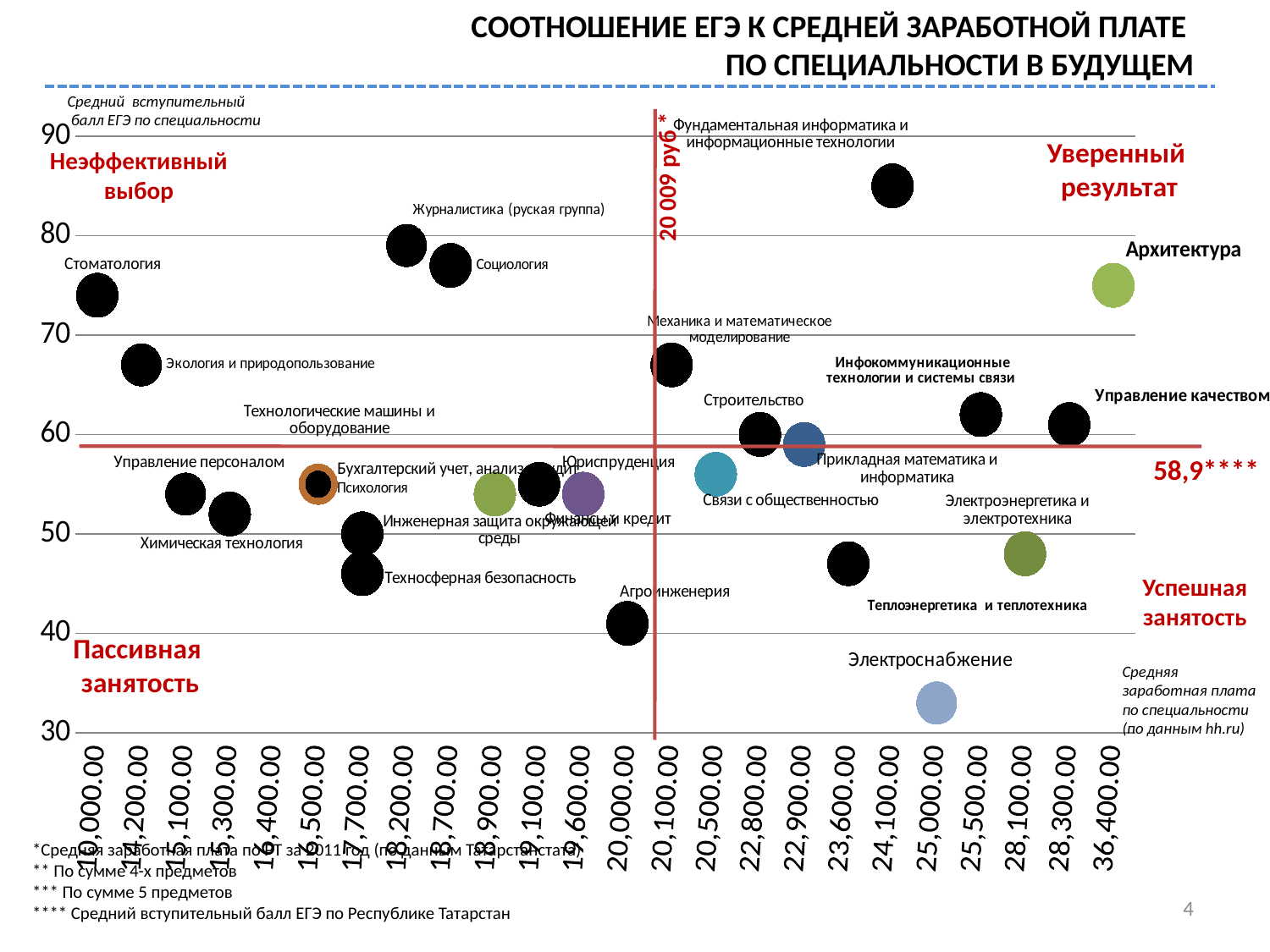
Is the EGE score for Стоматология greater or less than 70? greater Is the EGE score for Экология и природопользование greater or less than 70? less What value is marked by the horizontal red line on the chart? 58,9 Which specialty has the lowest average entrance EGE score on the chart? Электроснабжение Which has a higher EGE score, Архитектура or Электроснабжение? Архитектура What salary value is marked by the vertical red line on the chart? 20 009 руб Which has a higher EGE score, Стоматология or Экология и природопользование? Стоматология Is the EGE score for Техносферная безопасность greater or less than 50? less What kind of chart is shown on the slide? Scatter (bubble) chart Which specialty has the highest average entrance EGE score on the chart? Фундаментальная информатика и информационные технологии